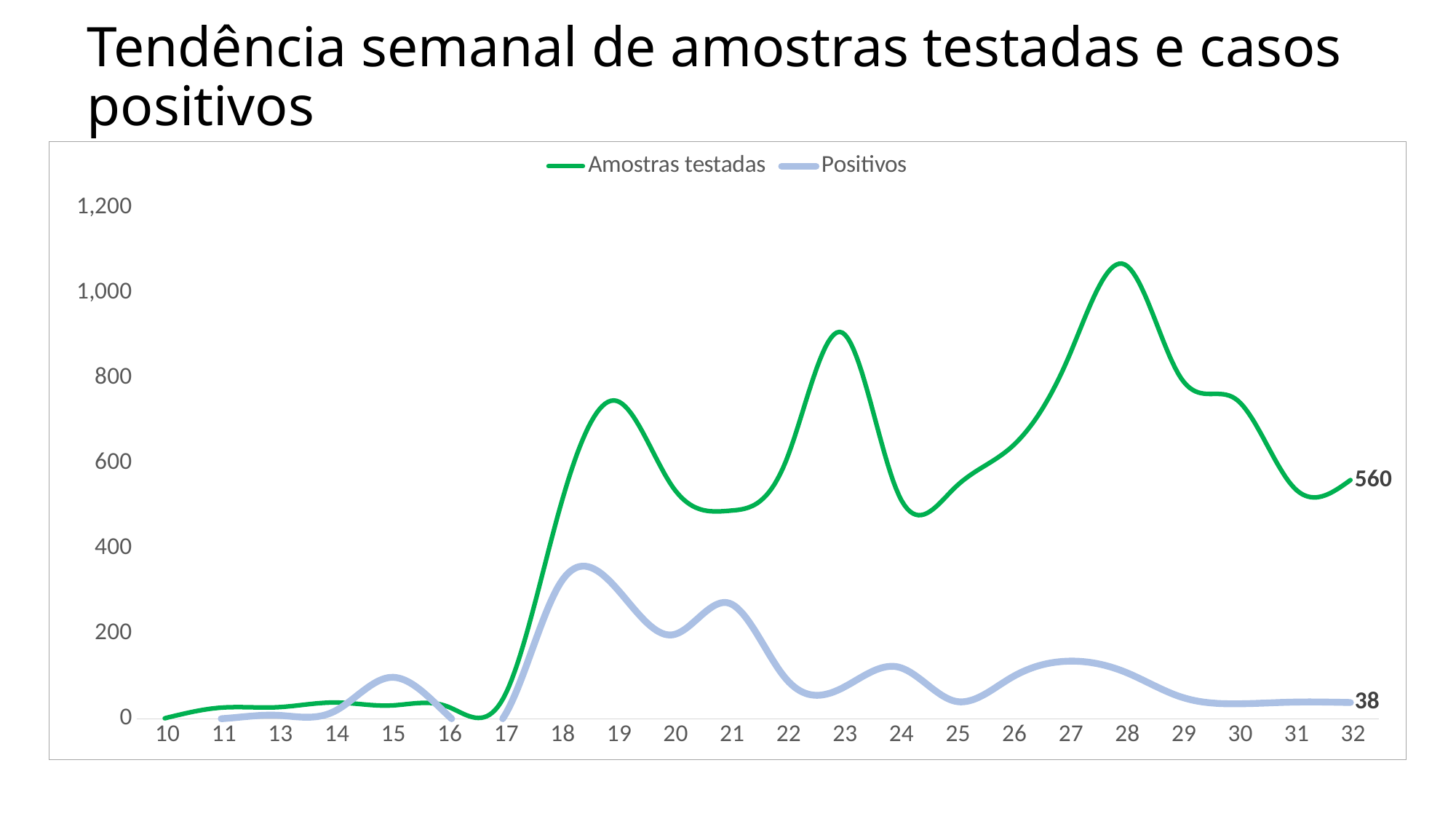
Is the value for Positivos at week 18 greater or less than 400? less In which week does Amostras testadas reach its highest value? 28 How many weeks are labelled on the x axis? 22 How many series does the legend list? 2 Does the Amostras testadas line rise or fall from week 28 to week 31? fall What kind of chart is shown on the slide? line chart In which week does Positivos reach its highest value? 18 What is the value of Amostras testadas at week 32? 560 Which week has a higher value for Amostras testadas, week 19 or week 23? 23 What is the value of Positivos at week 32? 38 Is the value for Amostras testadas at week 28 greater or less than 1,000? greater What is the difference between Amostras testadas and Positivos at week 32? 522